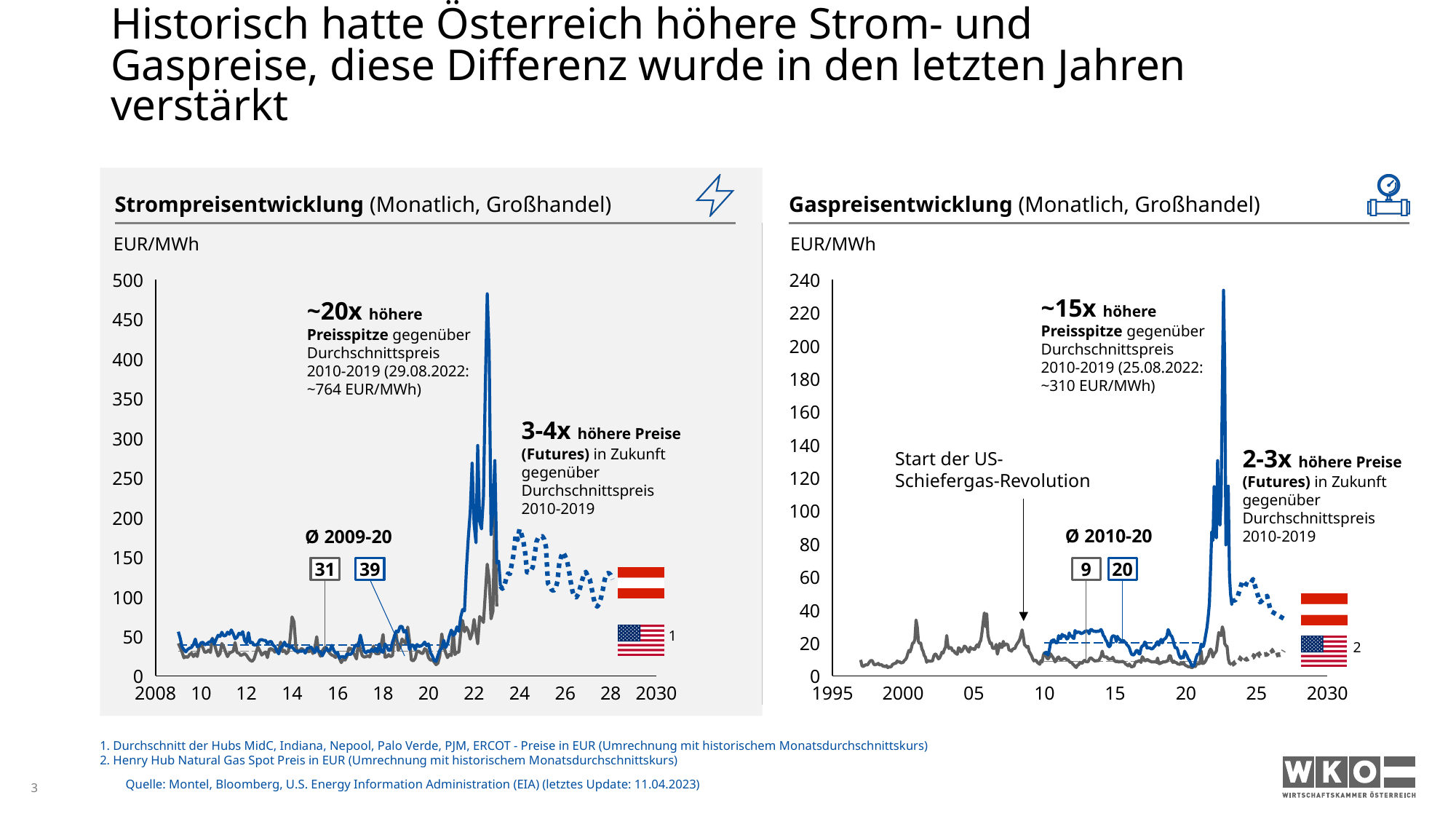
In the Gaspreisentwicklung chart, what is the average price for the US (grey series) for 2010-20? 9 In the Strompreisentwicklung chart, is the peak value of the Austrian (blue) series in 2022 greater or less than 450? greater In the Gaspreisentwicklung chart, what is the average price for Austria (blue series) for 2010-20? 20 In the Strompreisentwicklung chart, what is the average price for the US (grey series) for 2009-20? 31 What kind of chart is the Strompreisentwicklung chart on the left? line chart In the Strompreisentwicklung chart, what is the average price for Austria (blue series) for 2009-20? 39 What unit is shown on the y axis of both charts? EUR/MWh In the Strompreisentwicklung chart, what is the difference between the Austrian and US average prices for 2009-20? 8 In the Gaspreisentwicklung chart, which series has the higher 2010-20 average, Austria or the US? Austria In the Gaspreisentwicklung chart, is the peak value of the Austrian (blue) series in 2022 greater or less than 220? greater In the Gaspreisentwicklung chart, do the dotted futures values for Austria rise or fall from 2024 to 2027? fall